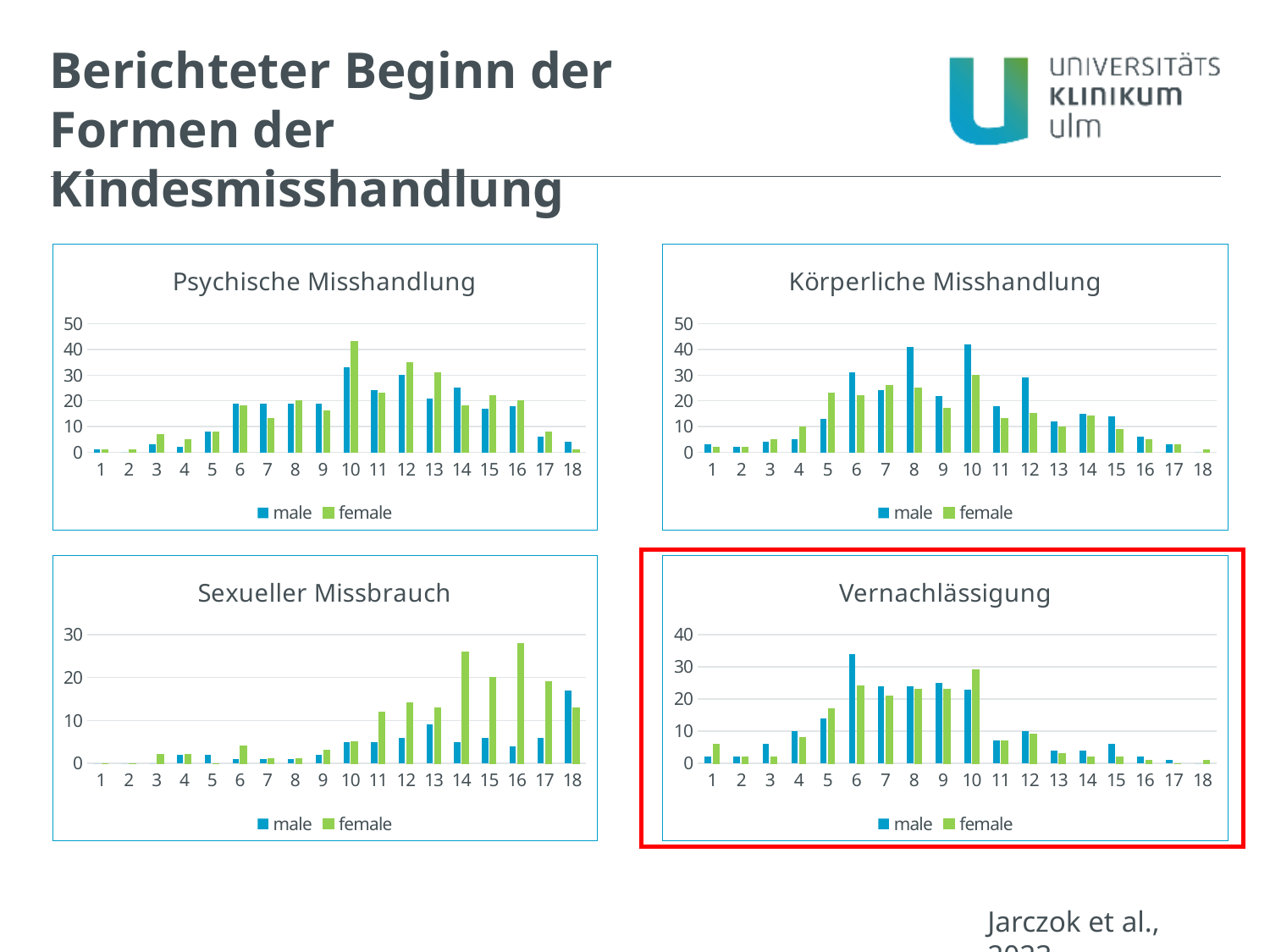
What type of chart is the "Psychische Misshandlung" chart? bar chart In the "Vernachlässigung" chart, at which age is the male value highest? 6 In the "Vernachlässigung" chart, which is larger at age 6, the male or the female value? male In the "Psychische Misshandlung" chart, at which age is the female value highest? 10 In the "Körperliche Misshandlung" chart, is the female value at age 5 greater or less than 20? greater How many age categories are shown on the x axis of the "Sexueller Missbrauch" chart? 18 In the "Sexueller Missbrauch" chart, at which age is the female value highest? 16 In the "Sexueller Missbrauch" chart, is the female value at age 16 greater or less than 20? greater In the "Psychische Misshandlung" chart, is the female value at age 10 greater or less than 40? greater Which of the four charts is outlined with a red box? Vernachlässigung How many series does the legend of the "Vernachlässigung" chart list? 2